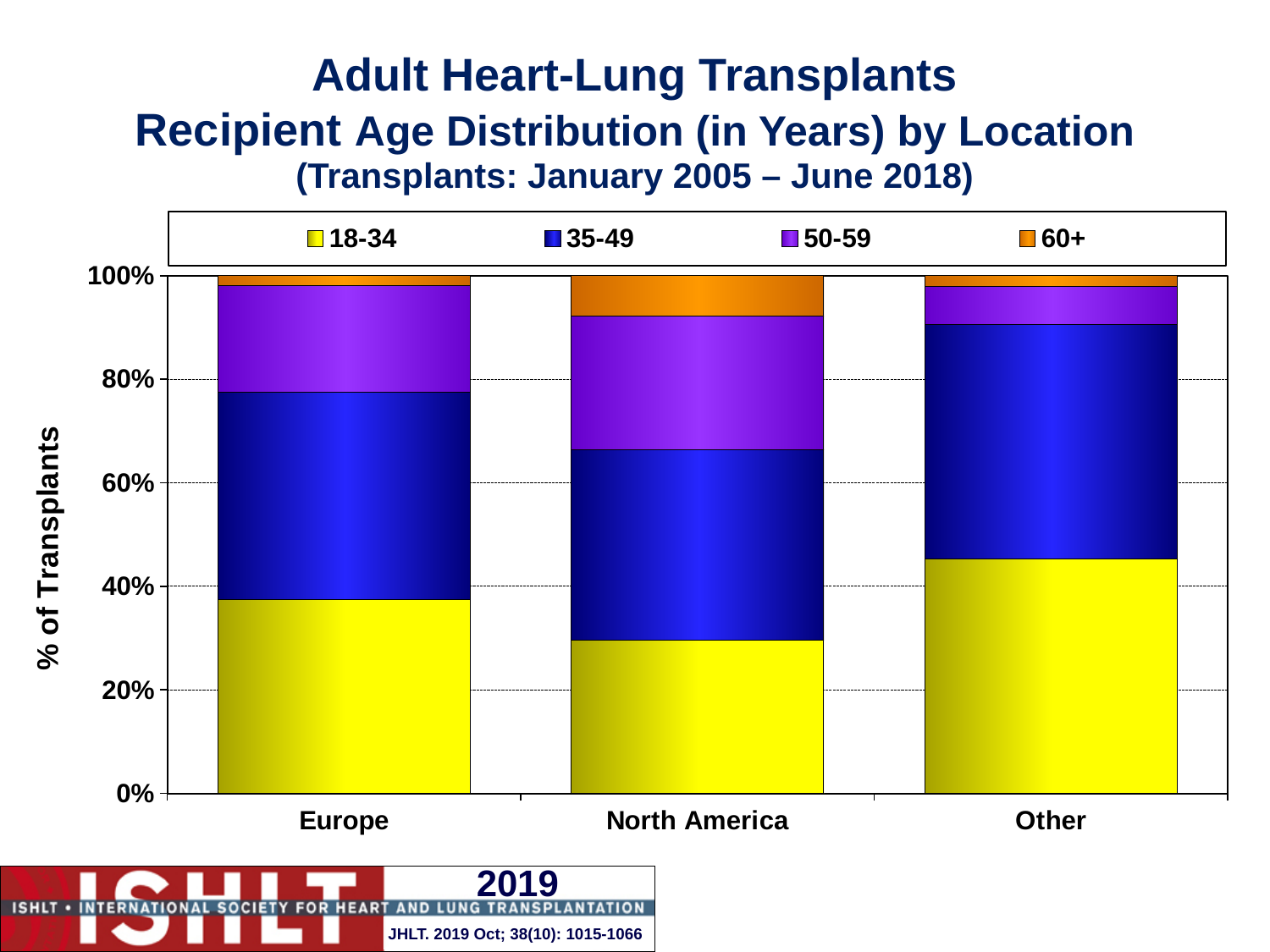
What kind of chart is shown on the slide? Stacked bar chart Which location has the largest share of recipients aged 18-34? Other How many age groups does the legend list? 4 Which is larger: the 18-34 share in Europe or the 18-34 share in North America? Europe Which location has the largest share of recipients aged 50-59? North America How many locations are shown on the x axis? 3 Which location has the smallest share of recipients aged 50-59? Other Which location has the smallest share of recipients aged 18-34? North America Is the share of recipients aged 18-34 in Europe greater or less than 40%? less Which colour represents the 35-49 age group in the legend? Blue Which location has the largest share of recipients aged 60+? North America Is the share of recipients aged 18-34 in Other greater or less than 40%? greater